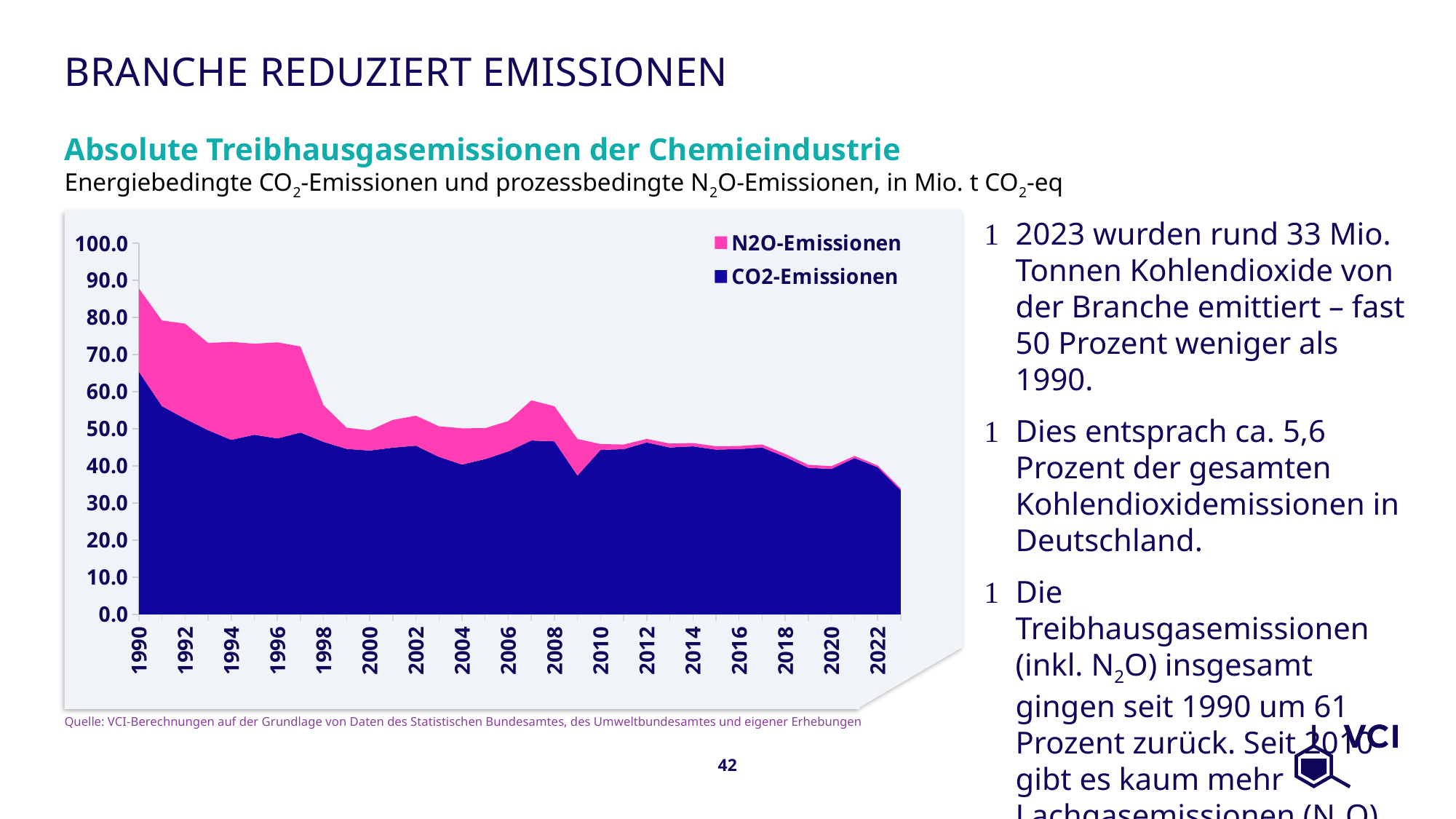
Do the total emissions in the chart rise or fall from 1990 to 2022? Fall In which year are the total emissions (CO2 plus N2O) highest? 1990 Are the total emissions in 1990 greater or less than 80.0? greater Which is larger: the CO2-Emissionen in 1990 or in 2022? 1990 Are the CO2-Emissionen in 1990 greater or less than 60.0? greater What kind of chart is shown on the slide? Stacked area chart Which two series are listed in the chart's legend? N2O-Emissionen and CO2-Emissionen How many year labels are shown on the x axis? 17 Are the total emissions in 2010 greater or less than 60.0? less Which colour represents CO2-Emissionen in the chart? Dark blue How many series does the chart's legend list? 2